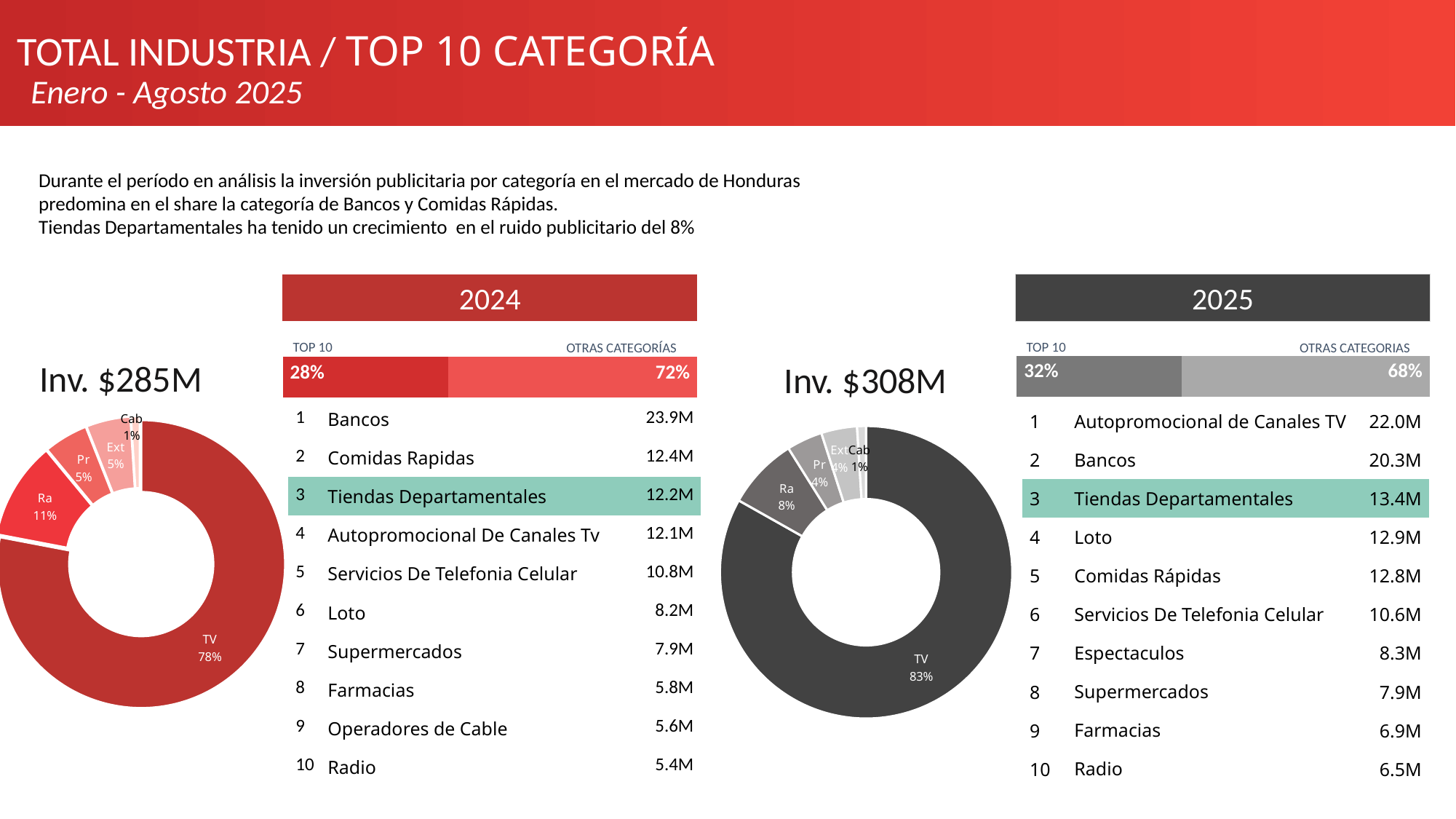
What kind of chart is used to show the media split for 2024 and 2025? Donut chart In the 2024 donut chart (left), what share does TV have? 78% How many segments does the 2024 donut chart (left) have? 5 In the 2025 donut chart (right), which segment is the smallest? Cab In the 2024 donut chart (left), what share does Ra have? 11% In the 2025 donut chart (right), what share does Ra have? 8% In the 2024 donut chart (left), which segment is the largest? TV Which is larger: the Ra share in the 2024 donut chart or the Ra share in the 2025 donut chart? 2024 What is the difference between the TV share in the 2025 donut chart and the TV share in the 2024 donut chart? 5% In the 2025 stacked bar, what share is labelled OTRAS CATEGORIAS? 68% In the 2024 stacked bar, what share is labelled TOP 10? 28% In the 2025 donut chart (right), what share does TV have? 83%